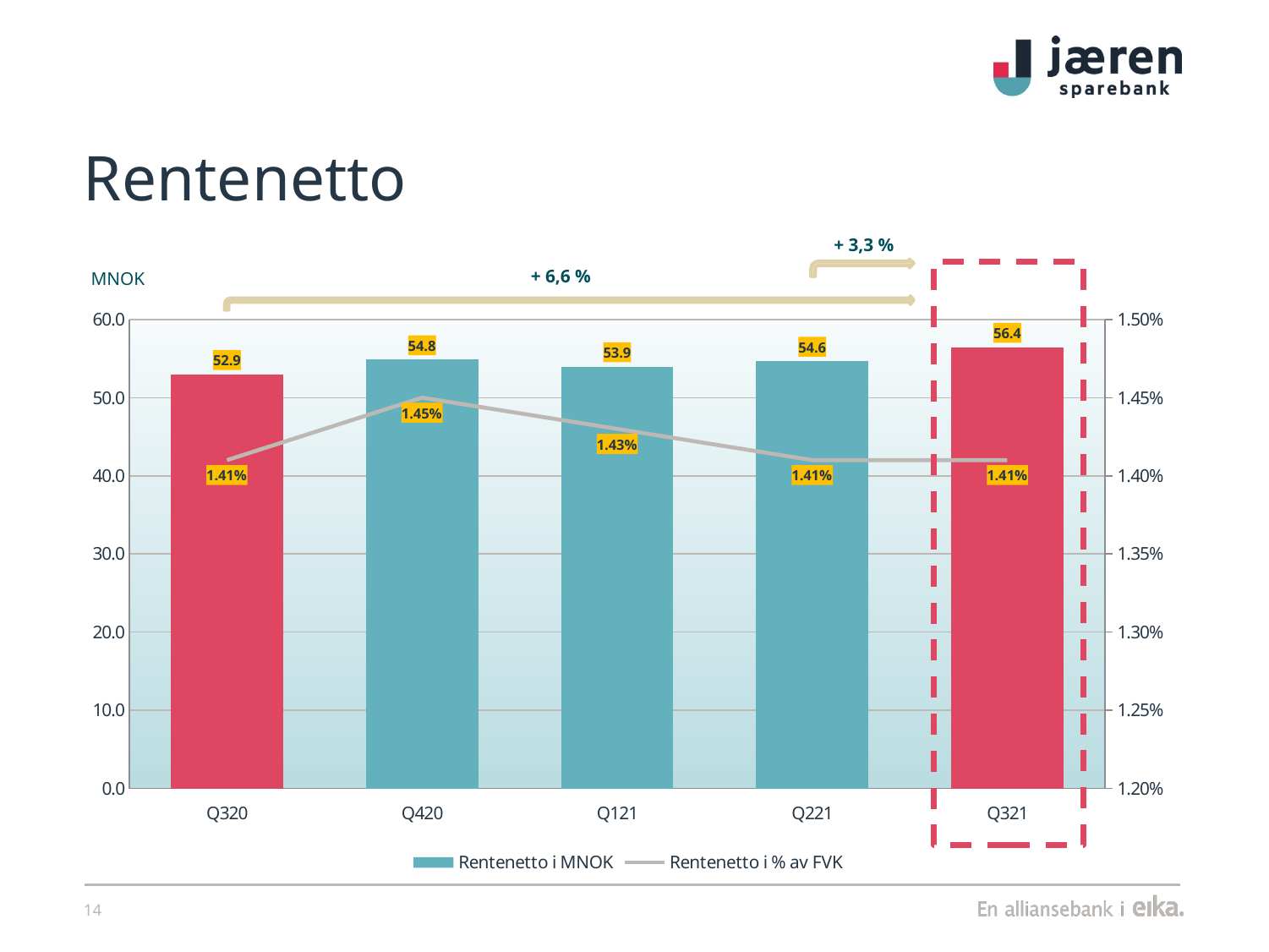
How many series does the legend list? 2 Which quarter has the highest Rentenetto i % av FVK? Q420 Which is larger, the Rentenetto i MNOK for Q420 or for Q221? Q420 What is the Rentenetto i % av FVK value for Q420? 1.45% Which quarter has the highest Rentenetto i MNOK? Q321 What kind of chart is used for the Rentenetto i MNOK series? Bar chart What is the difference in Rentenetto i MNOK between Q321 and Q320? 3.5 Which quarter has the lowest Rentenetto i MNOK? Q320 What percentage growth is shown by the arrow from Q320 to Q321? + 6,6 % What is the Rentenetto i MNOK value for Q121? 53.9 How many quarters are shown on the x axis? 5 What is the Rentenetto i MNOK value for Q321? 56.4